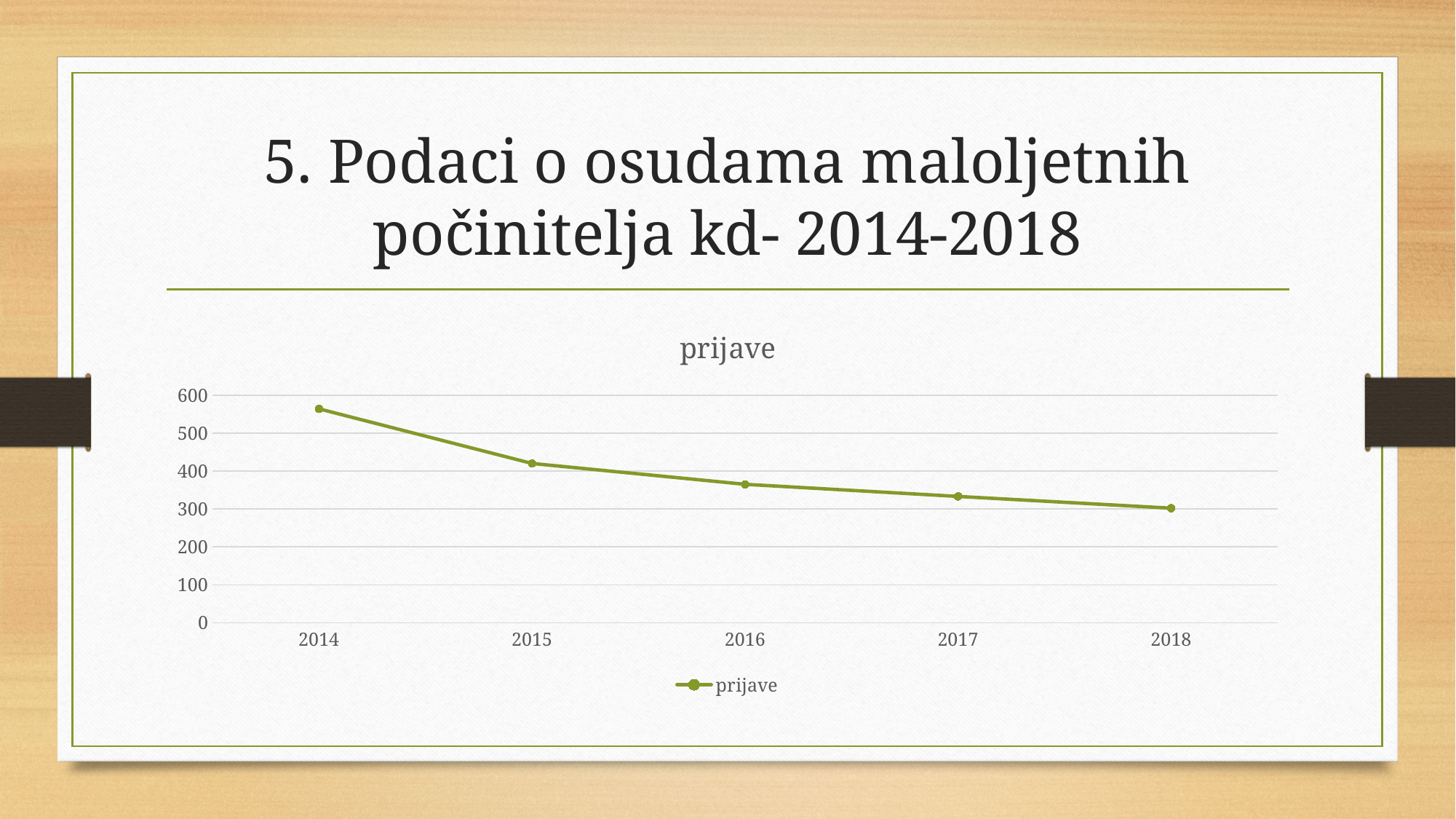
Which is larger, the value for 2015 or the value for 2017? 2015 Is the value for 2015 greater or less than 500? less How many years are plotted on the x axis? 5 Is the value for 2017 greater or less than 300? greater Is the value for 2014 greater or less than 500? greater Do the values rise or fall from 2014 to 2018? fall Which year has the lowest value? 2018 What is the title of the chart? prijave What kind of chart is shown on the slide? line chart Which year has the highest value? 2014 How many series does the legend list? 1